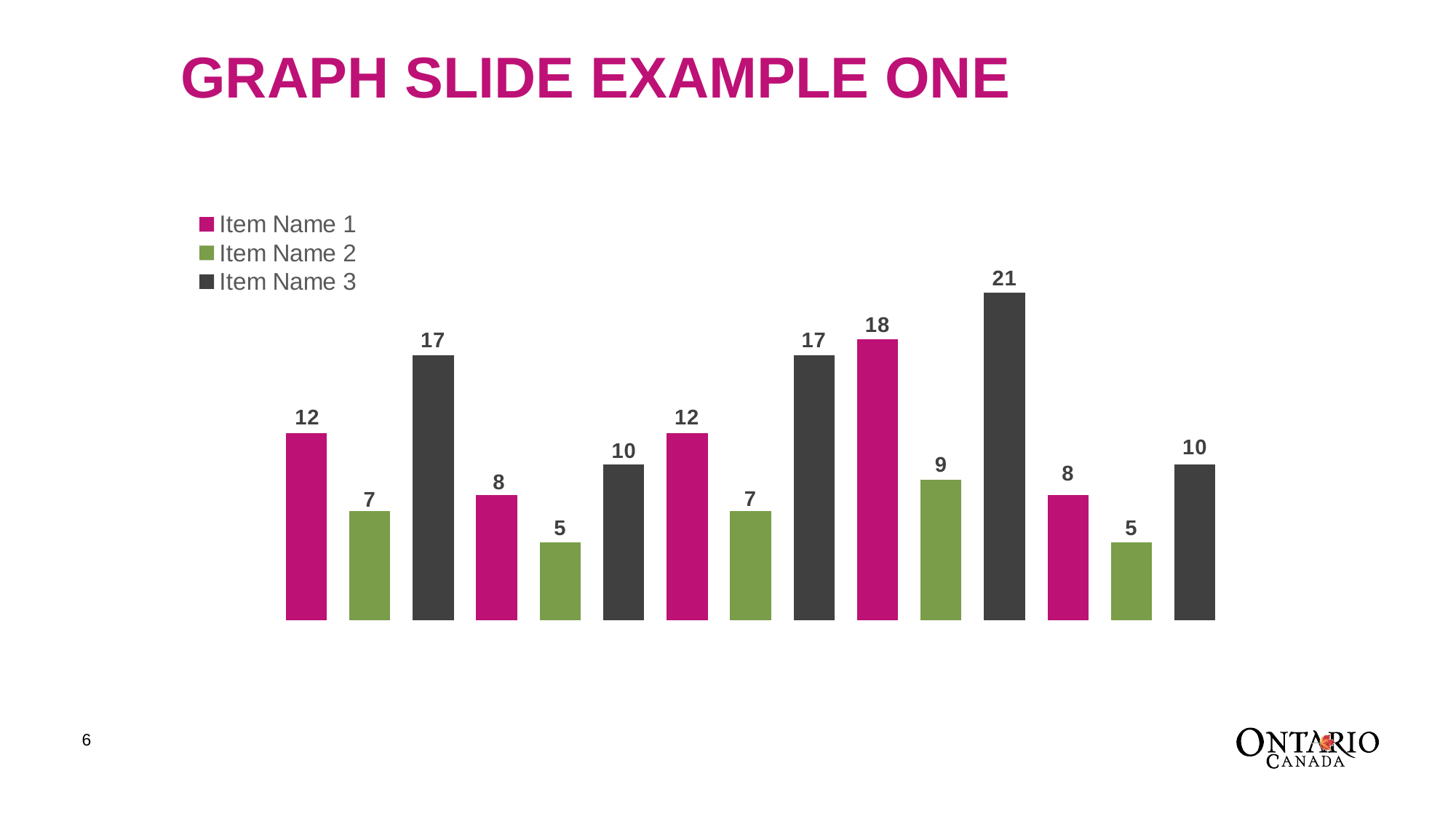
Which series is shown in green in the legend? Item Name 2 What is the value of the Item Name 1 bar in the fourth group of bars? 18 What is the lowest value shown in the chart? 5 What is the highest value shown in the chart? 21 In the fourth group of bars, what is the difference between the Item Name 3 value and the Item Name 1 value? 3 What is the value of the Item Name 3 bar in the first group of bars (leftmost)? 17 What kind of chart is shown on the slide? bar chart How many series does the legend list? 3 What is the value of the Item Name 2 bar in the second group of bars? 5 In the first group of bars, which series has the larger value, Item Name 1 or Item Name 2? Item Name 1 What is the title of the slide containing the chart? GRAPH SLIDE EXAMPLE ONE How many groups of bars are plotted in the chart? 5